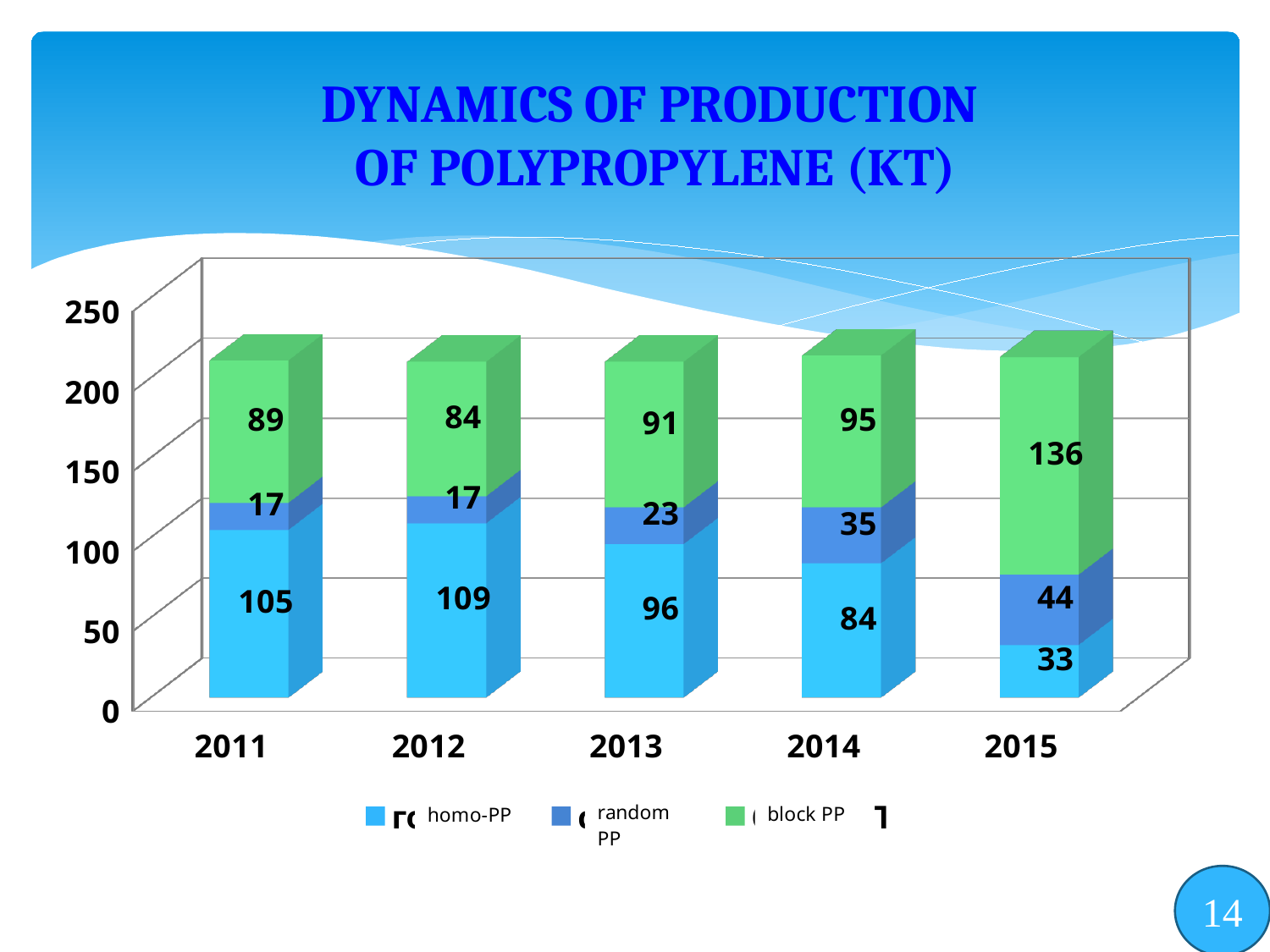
How many series does the legend list? 3 How many years are shown on the x axis? 5 What is the total of the stacked bar for 2014? 214 Does the random PP value rise or fall from 2011 to 2015? Rise What is the difference between the homo-PP values in 2012 and 2013? 13 In which year is the homo-PP value lowest? 2015 What is the value for block PP in 2015? 136 In which year is the block PP value highest? 2015 What is the value for homo-PP in 2011? 105 What kind of chart is shown on the slide? Stacked bar chart What is the value for random PP in 2014? 35 Which is larger, the random PP value in 2013 or in 2015? 2015